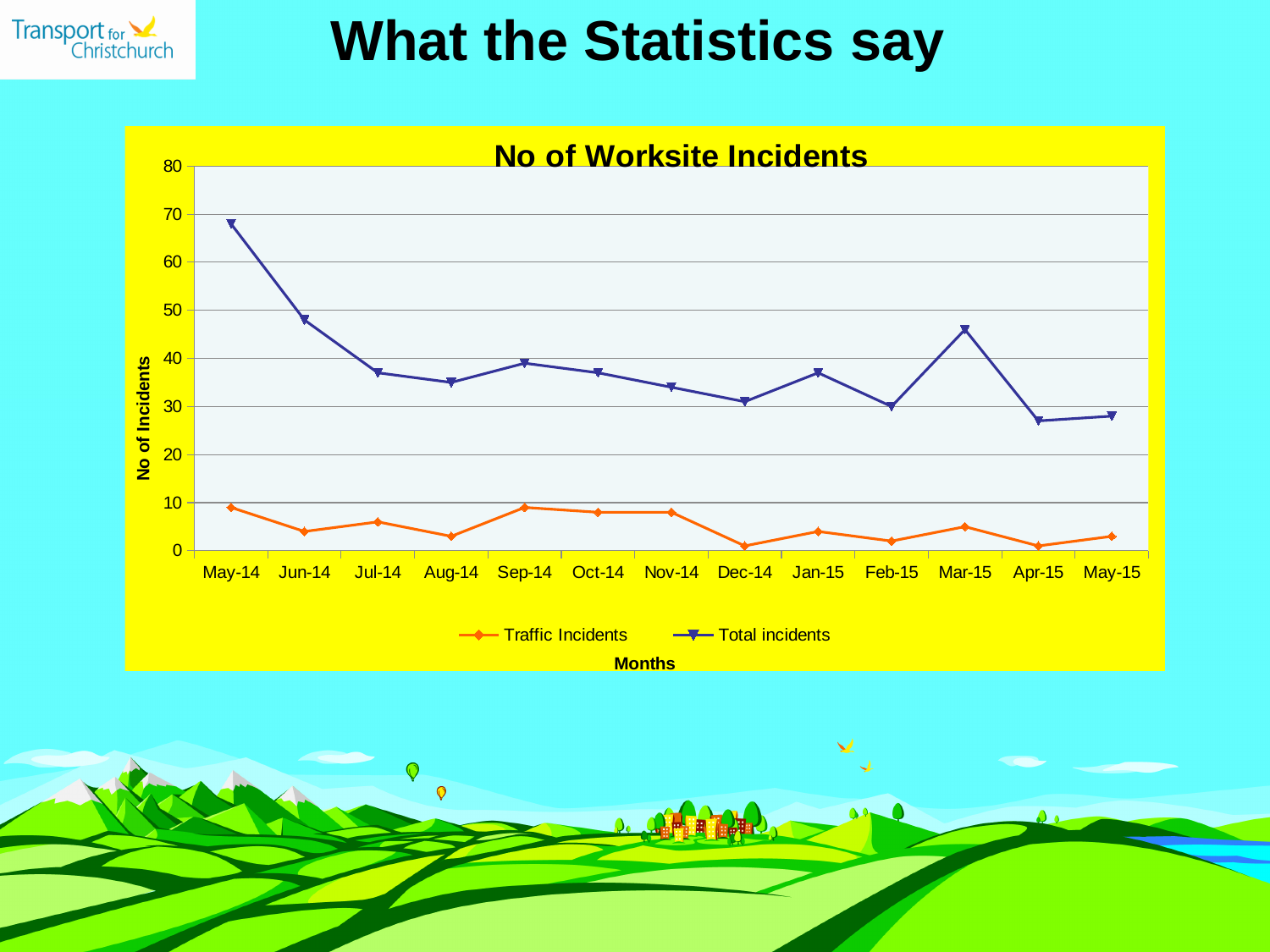
Do Total incidents rise or fall from May-14 to Jul-14? fall Which month has the larger Traffic Incidents value, Sep-14 or Dec-14? Sep-14 What is the title of the chart? No of Worksite Incidents Is the Total incidents value for May-14 greater or less than 60? greater Is the Total incidents value for Mar-15 greater or less than 40? greater Is the Total incidents value for Apr-15 greater or less than 30? less How many series does the legend list? 2 Which month has the larger Total incidents value, Feb-15 or Mar-15? Mar-15 What kind of chart is shown on the slide? line chart How many months are plotted along the x axis? 13 In which month is the Total incidents value highest? May-14